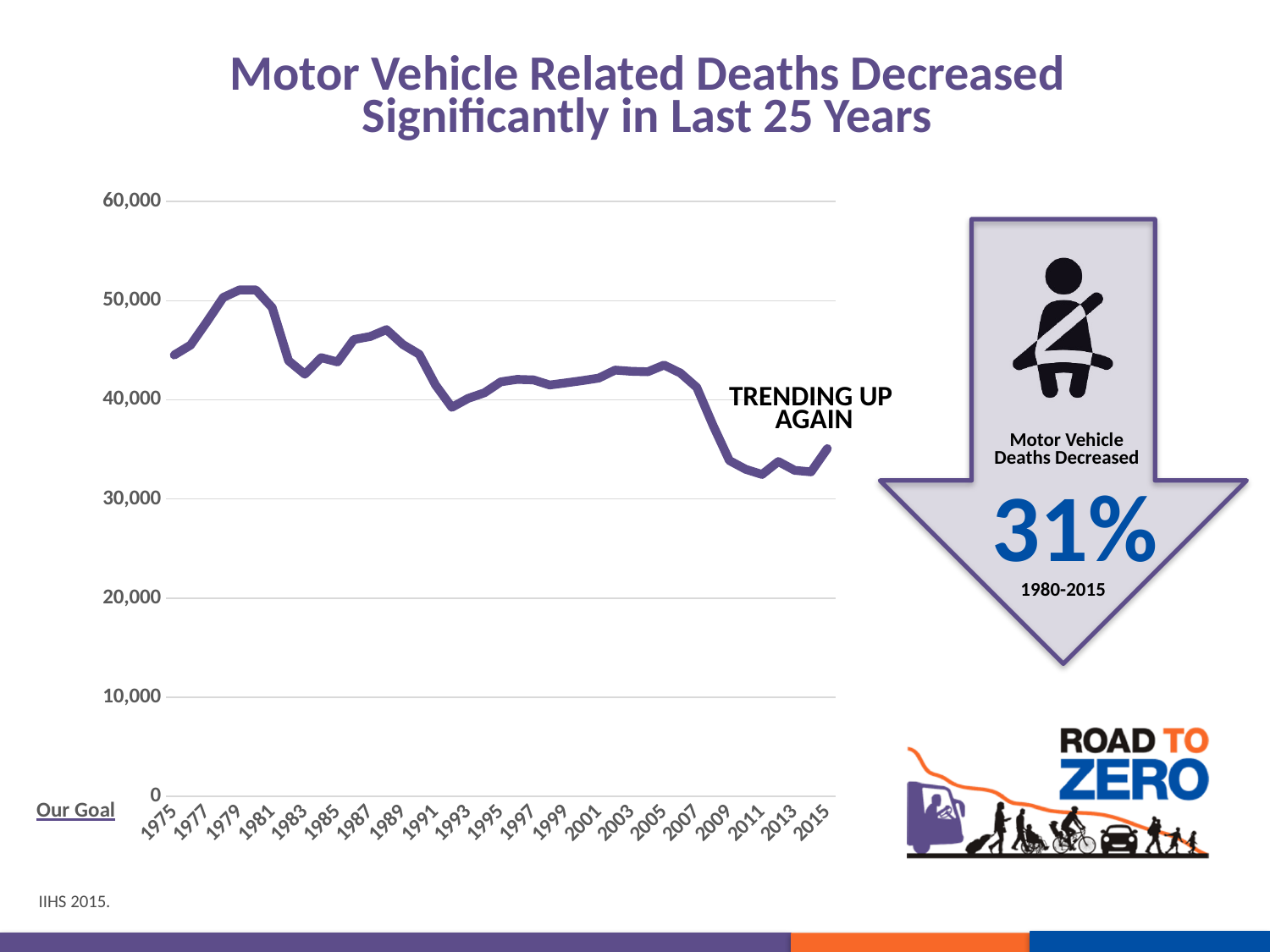
Is the value for 2011 greater or less than 40,000? less Is the value for 1975 greater or less than 40,000? greater What is the highest value shown on the y axis? 60,000 What annotation text is placed next to the end of the line? TRENDING UP AGAIN Which is larger, the value for 1975 or the value for 2015? 1975 Is the value for 1985 greater or less than 40,000? greater Overall, do motor vehicle related deaths rise or fall from 1975 to 2015 along the x axis? fall Which is larger, the value for 2005 or the value for 2011? 2005 What kind of chart is shown on the slide? line chart How many year labels are shown on the x axis? 21